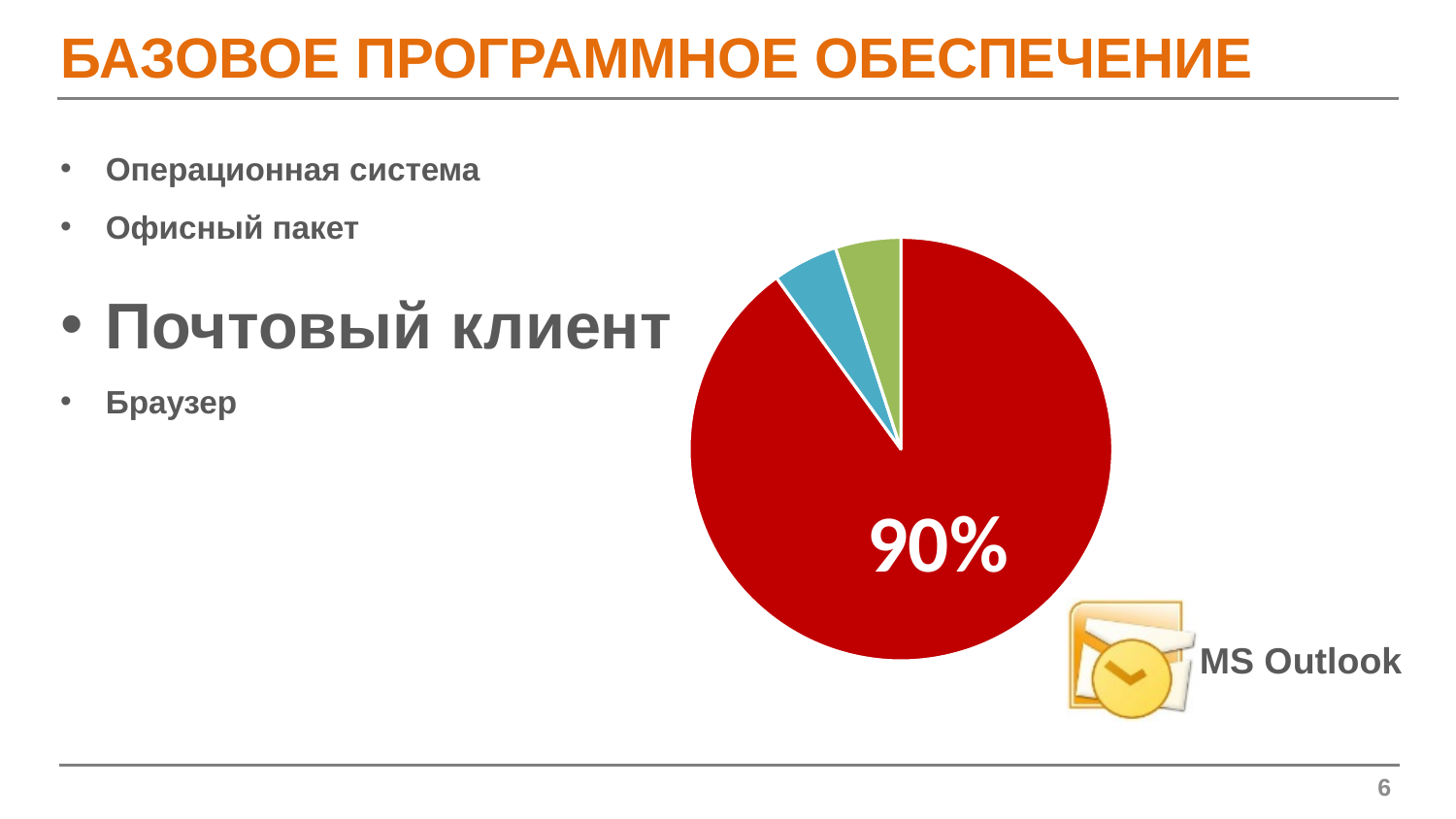
What share of the pie does the MS Outlook slice represent? 90% Which is larger in the pie chart, the red slice or the blue slice? the red slice Which software is labelled next to the largest slice of the pie chart? MS Outlook What combined share do the two small slices (blue and green) make up together? 10% Does the pie chart include a legend? No How many slices does the pie chart have? 3 Is the share for MS Outlook greater or less than 50%? greater What percentage is printed on the largest slice of the pie chart? 90% What kind of chart is shown on the slide? pie chart What colour is the slice labelled 90%? red